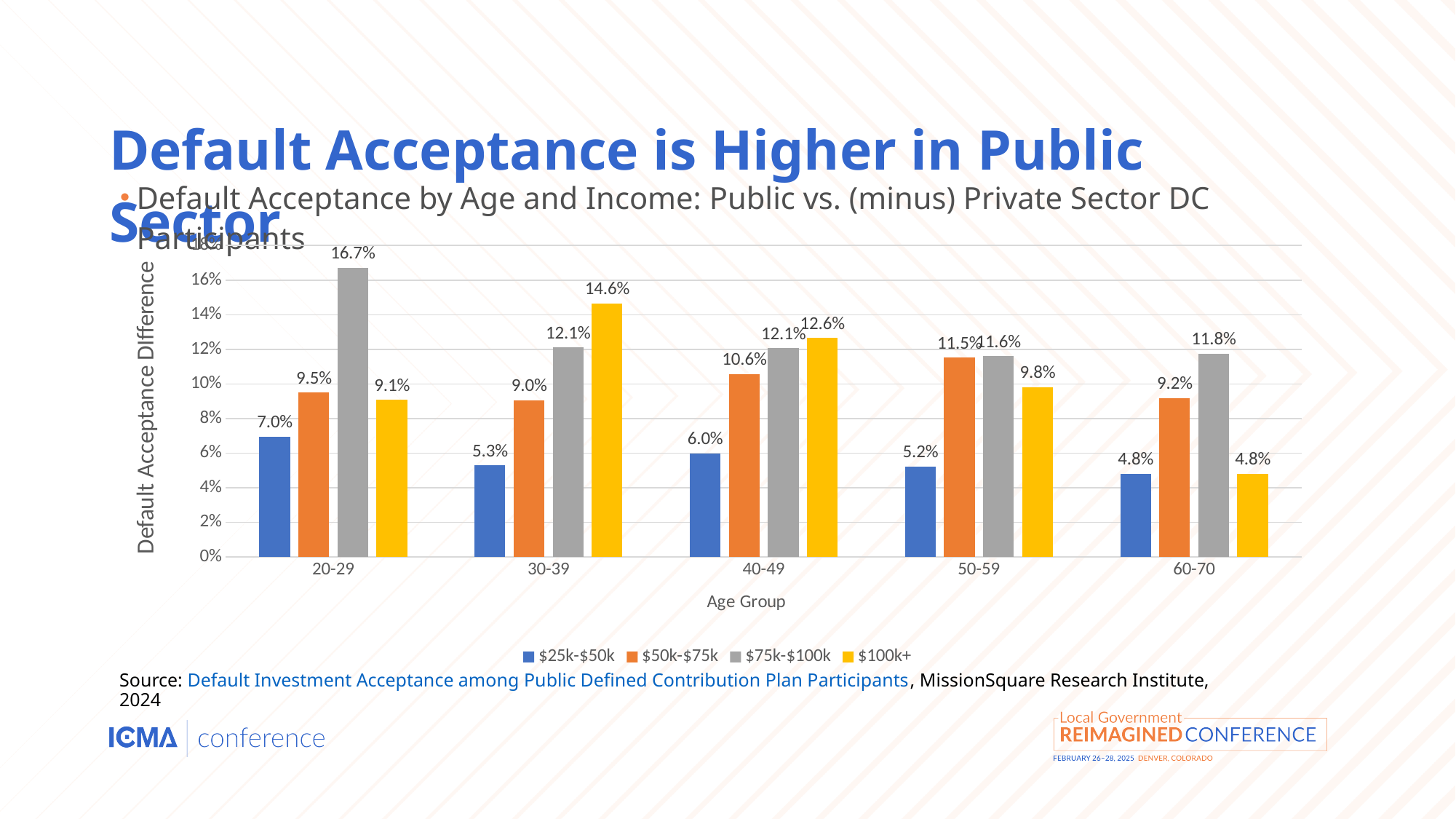
What kind of chart is shown on the slide? Bar chart What is the difference between the $75k-$100k and $25k-$50k values in the 20-29 age group? 9.7% How many series does the legend list? 4 What is the value for the $25k-$50k series in the 50-59 age group? 5.2% What is the label of the y axis? Default Acceptance Difference In the 60-70 age group, which is larger: the $50k-$75k value or the $75k-$100k value? $75k-$100k What is the value for the $100k+ series in the 30-39 age group? 14.6% Which age group has the lowest value for the $100k+ series? 60-70 What is the value for the $75k-$100k series in the 20-29 age group? 16.7% How many age groups are shown on the x axis? 5 Which age group has the highest value for the $25k-$50k series? 20-29 What is the value for the $50k-$75k series in the 40-49 age group? 10.6%